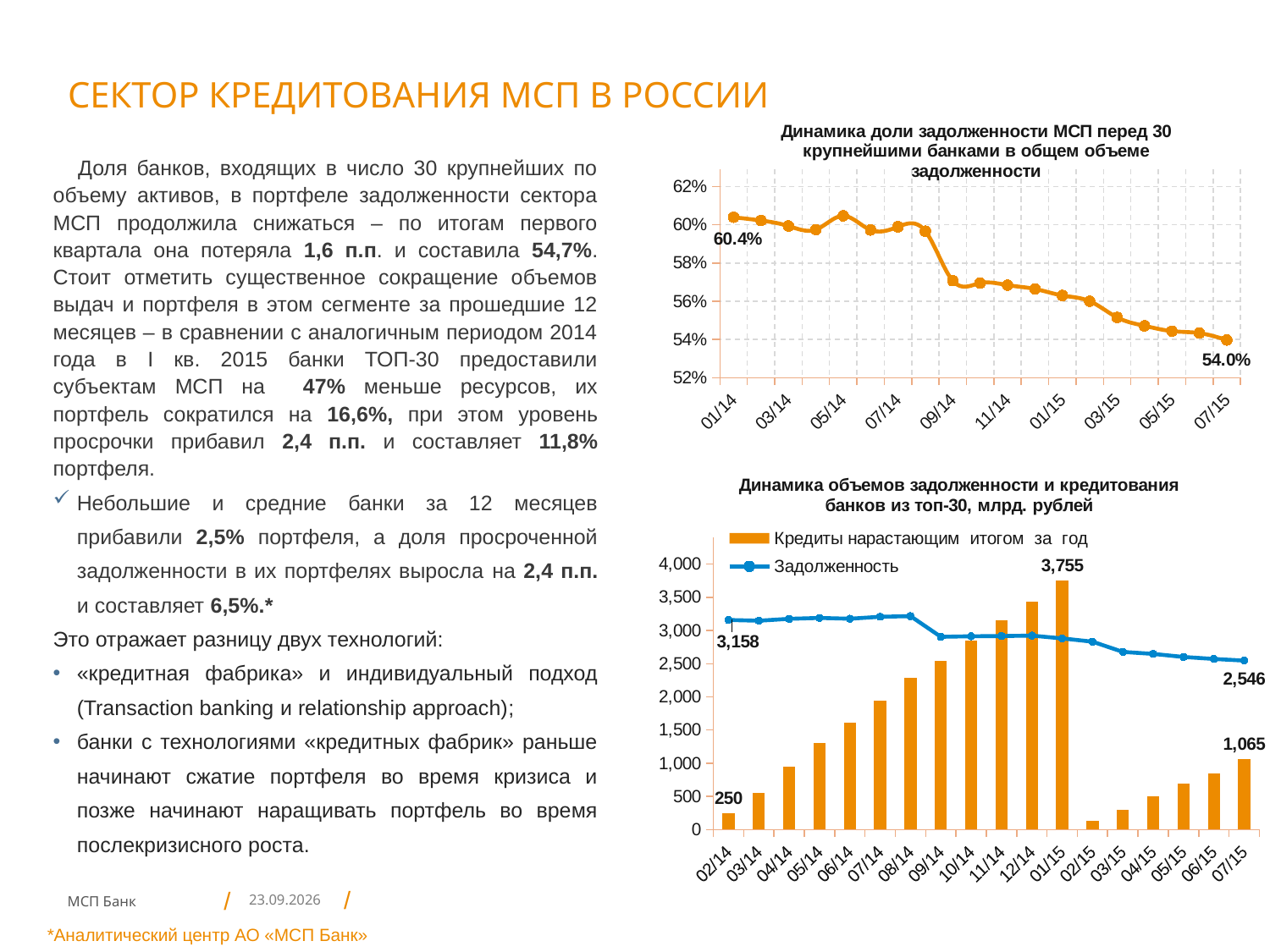
In the top chart (Динамика доли задолженности МСП перед 30 крупнейшими банками), what is the value for 01/14? 60.4% In the top chart (Динамика доли задолженности МСП перед 30 крупнейшими банками), what is the value for 07/15? 54.0% In the bottom chart (Динамика объемов задолженности и кредитования банков из топ-30), which month has the highest bar for Кредиты нарастающим итогом за год? 01/15 In the top chart (Динамика доли задолженности МСП перед 30 крупнейшими банками), do the values rise or fall along the x axis overall? fall In the bottom chart (Динамика объемов задолженности и кредитования банков из топ-30), what is the value of Кредиты нарастающим итогом за год for 01/15? 3,755 In the bottom chart (Динамика объемов задолженности и кредитования банков из топ-30), what is the difference between Задолженность at 02/14 and at 07/15? 612 In the top chart (Динамика доли задолженности МСП перед 30 крупнейшими банками), is the value for 09/14 greater or less than 58%? less In the bottom chart (Динамика объемов задолженности и кредитования банков из топ-30), what is the value of Задолженность for 07/15? 2,546 In the top chart (Динамика доли задолженности МСП перед 30 крупнейшими банками), by how many percentage points did the share fall from 01/14 to 07/15? 6.4 percentage points How many series does the legend of the bottom chart (Динамика объемов задолженности и кредитования банков из топ-30) list? 2 What kind of chart is the top chart (Динамика доли задолженности МСП перед 30 крупнейшими банками)? line chart In the bottom chart (Динамика объемов задолженности и кредитования банков из топ-30), what is the value of Задолженность for 02/14? 3,158